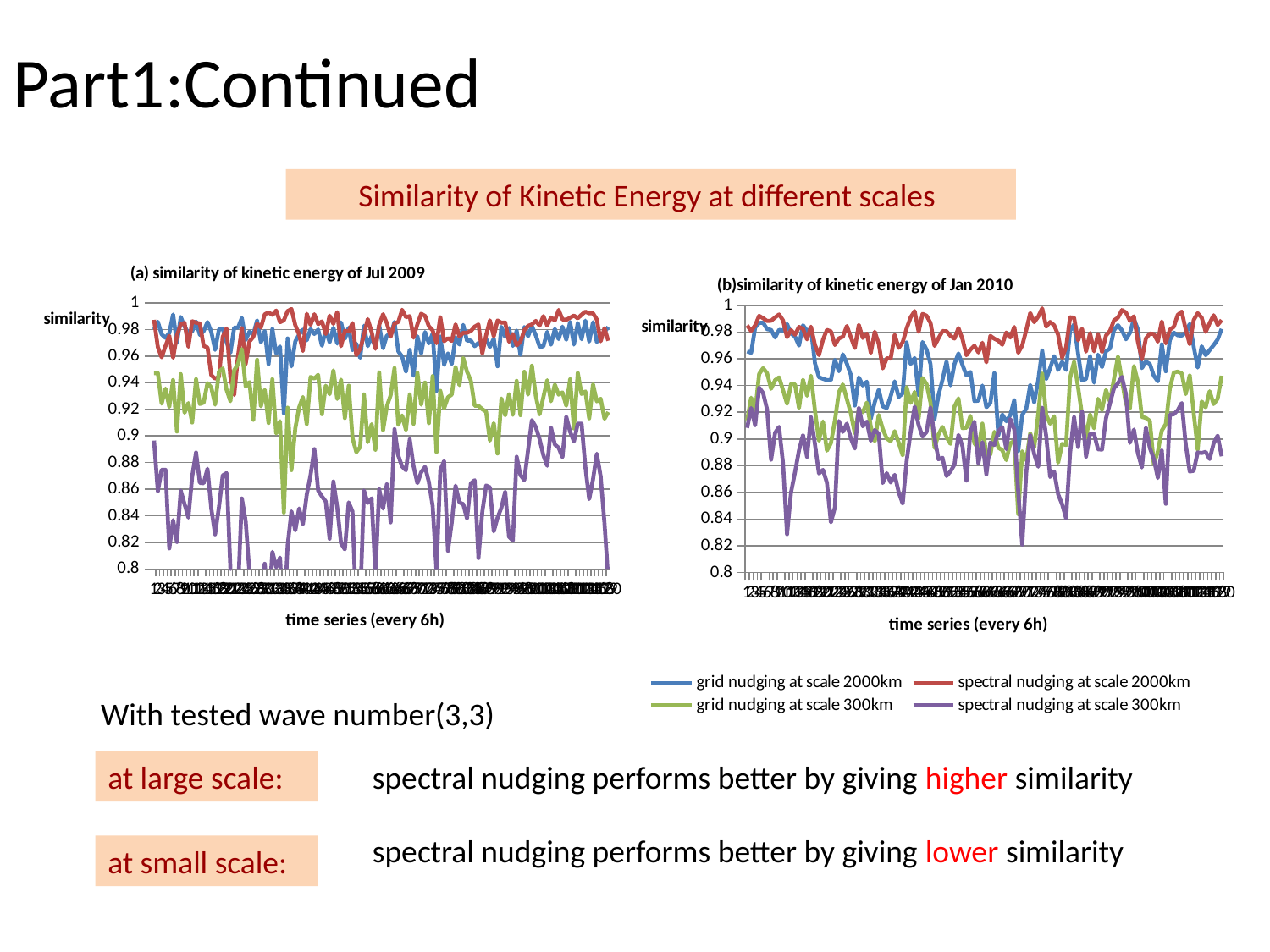
In the chart titled "(a) similarity of kinetic energy of Jul 2009", are the values for spectral nudging at scale 2000km greater or less than 0.9 throughout the series? greater What colour is the line for spectral nudging at scale 2000km in the legend? red In the chart titled "(a) similarity of kinetic energy of Jul 2009", are the values for spectral nudging at scale 300km greater or less than 0.94 throughout the series? less In the chart titled "(b)similarity of kinetic energy of Jan 2010", which series has the highest similarity values overall? spectral nudging at scale 2000km In the chart titled "(a) similarity of kinetic energy of Jul 2009", which series is generally higher: spectral nudging at scale 2000km or grid nudging at scale 2000km? spectral nudging at scale 2000km What is the x-axis title of the chart titled "(b)similarity of kinetic energy of Jan 2010"? time series (every 6h) What kind of chart is the chart titled "(b)similarity of kinetic energy of Jan 2010"? line chart How many series does the shared legend list for the two charts? 4 In the chart titled "(b)similarity of kinetic energy of Jan 2010", are the values for grid nudging at scale 2000km greater or less than 0.86 throughout the series? greater In the chart titled "(a) similarity of kinetic energy of Jul 2009", which series has the lowest similarity values overall? spectral nudging at scale 300km What kind of chart is the chart titled "(a) similarity of kinetic energy of Jul 2009"? line chart In the chart titled "(b)similarity of kinetic energy of Jan 2010", which series is generally higher: grid nudging at scale 300km or spectral nudging at scale 300km? grid nudging at scale 300km